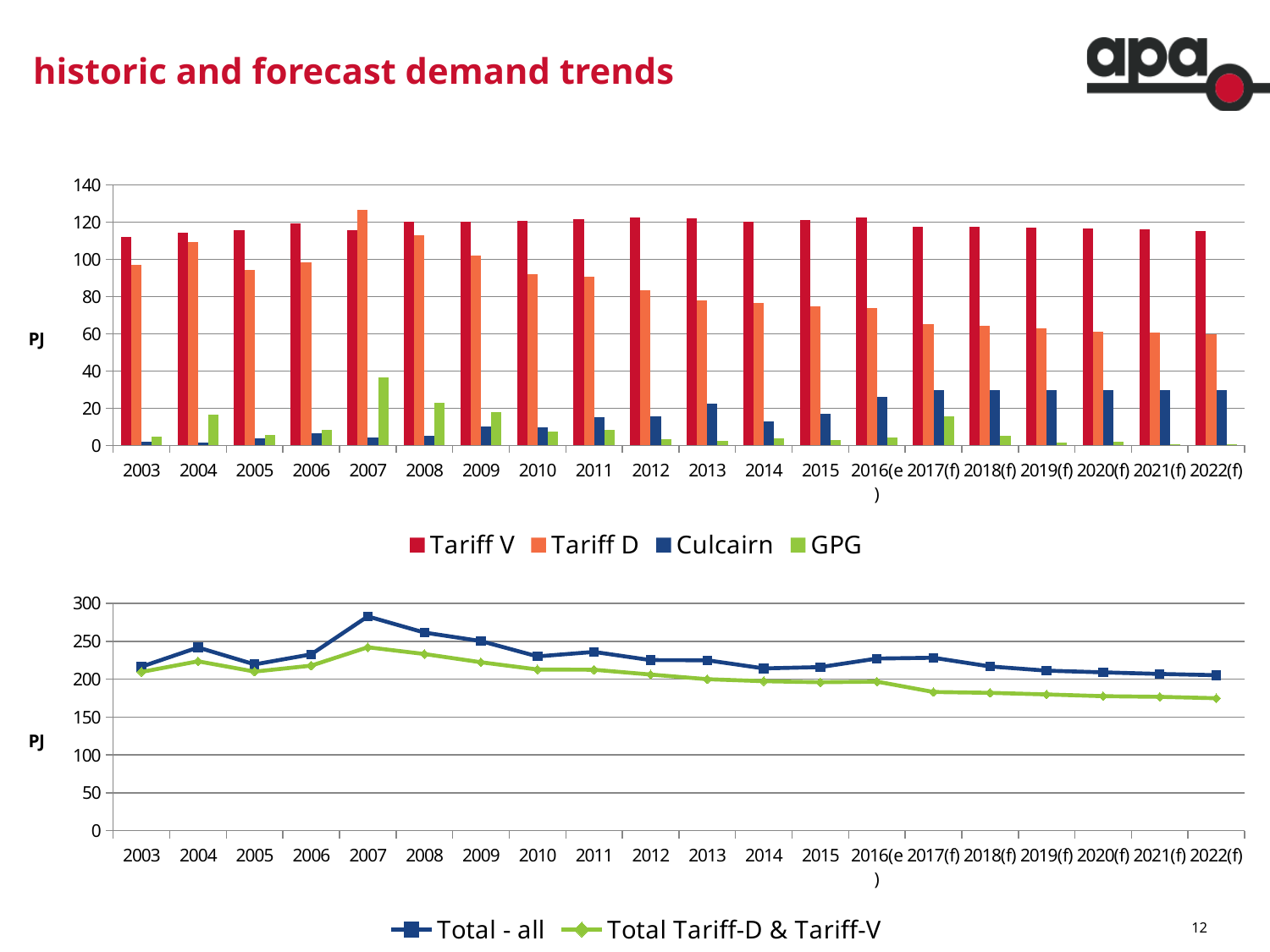
In the top bar chart, in which year is Tariff D highest? 2007 In the bottom line chart, is the value for Total Tariff-D & Tariff-V in 2022(f) greater or less than 200? less In the bottom line chart, how many years are shown on the x axis? 20 What kind of chart is the bottom chart on the slide? line chart In the top bar chart, is the value for Tariff D in 2007 greater or less than 120? greater In the bottom line chart, how many series does the legend list? 2 In the top bar chart, in which year is GPG highest? 2007 What kind of chart is the top chart on the slide? bar chart In the top bar chart, which is larger in 2022(f): Tariff V or Tariff D? Tariff V In the top bar chart, is the value for GPG in 2007 greater or less than 40? less In the bottom line chart, in which year is Total - all highest? 2007 In the top bar chart, how many series does the legend list? 4